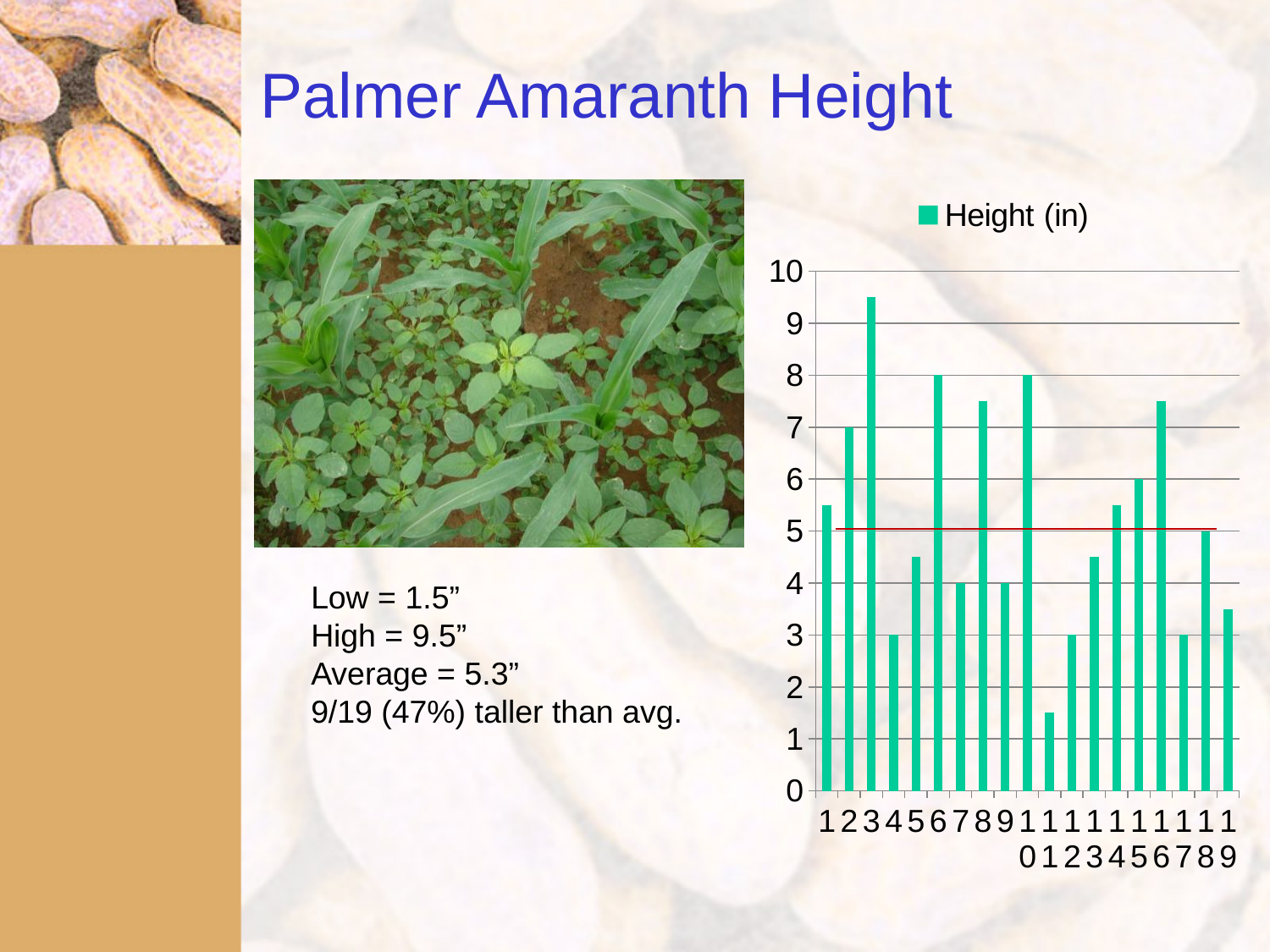
What is the height value for plant 15? 6 How many series does the chart legend list? 1 Is the height value for plant 8 greater or less than 7? greater What is the height value for plant 6? 8 What is the name of the series shown in the chart legend? Height (in) Which plant number has the tallest bar in the chart? 3 What kind of chart is shown on the slide? bar chart Which has the larger height value, plant 10 or plant 12? plant 10 How many bars (plants) are plotted in the chart? 19 What is the difference between the height of plant 2 and the height of plant 4? 4 Which plant number has the shortest bar in the chart? 11 What is the height value for plant 2? 7